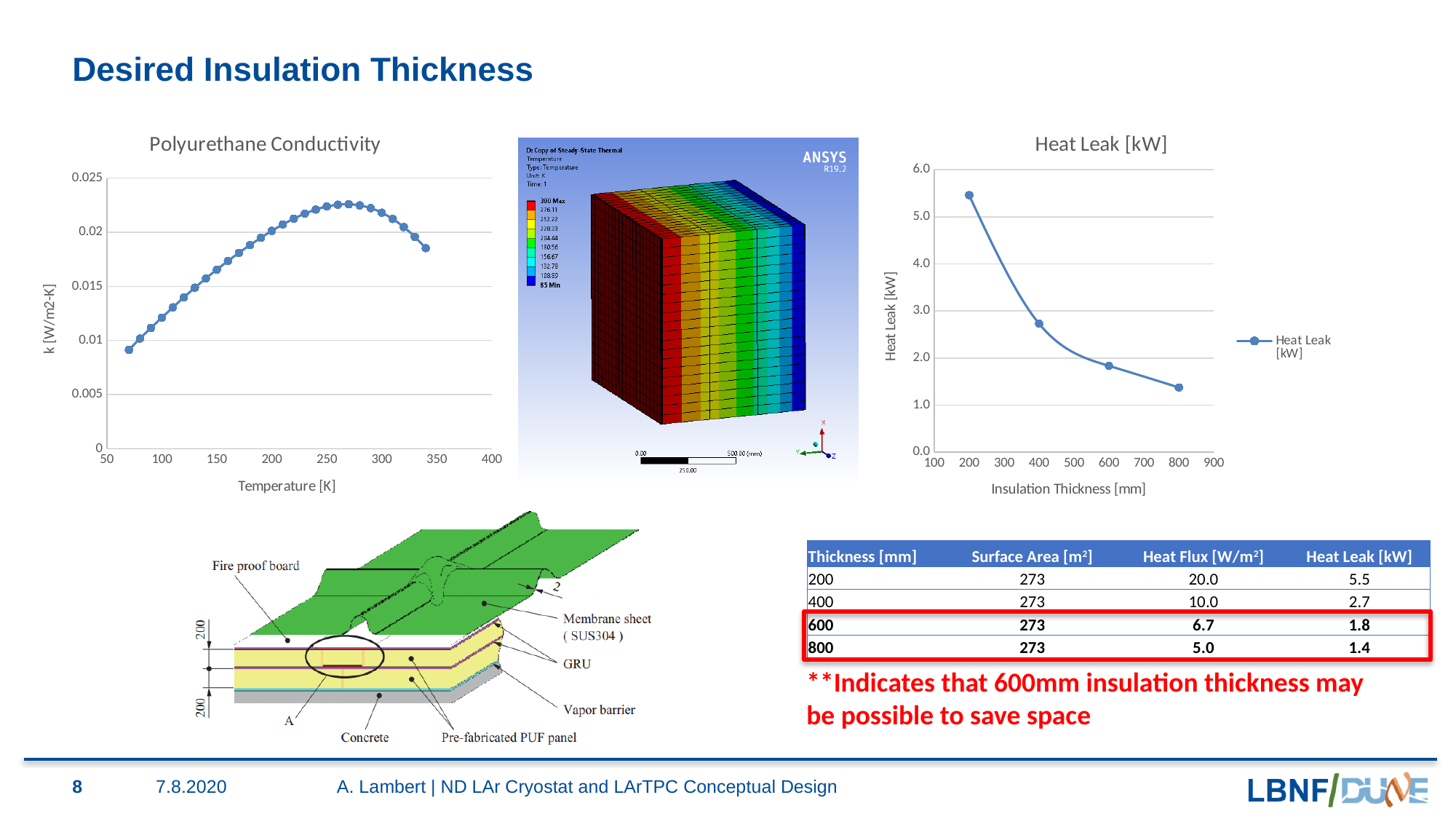
In the Polyurethane Conductivity chart, is the value at 100 K greater or less than 0.01? greater In the Polyurethane Conductivity chart, does the conductivity rise or fall between 100 K and 250 K? rise In the Heat Leak [kW] chart, which is larger: the heat leak at 400 mm or at 600 mm? 400 mm In the Heat Leak [kW] chart, is the value at 800 mm insulation thickness greater or less than 2.0? less In the Heat Leak [kW] chart, is the value at 200 mm insulation thickness greater or less than 5.0? greater How many series does the legend of the Heat Leak [kW] chart list? 1 How many data points are plotted in the Heat Leak [kW] chart? 4 In the Heat Leak [kW] chart, does the heat leak rise or fall as insulation thickness increases? fall What is the x-axis title of the Heat Leak [kW] chart? Insulation Thickness [mm] What kind of chart is the Heat Leak [kW] chart? line chart In the Heat Leak [kW] chart, which insulation thickness has the highest heat leak? 200 mm